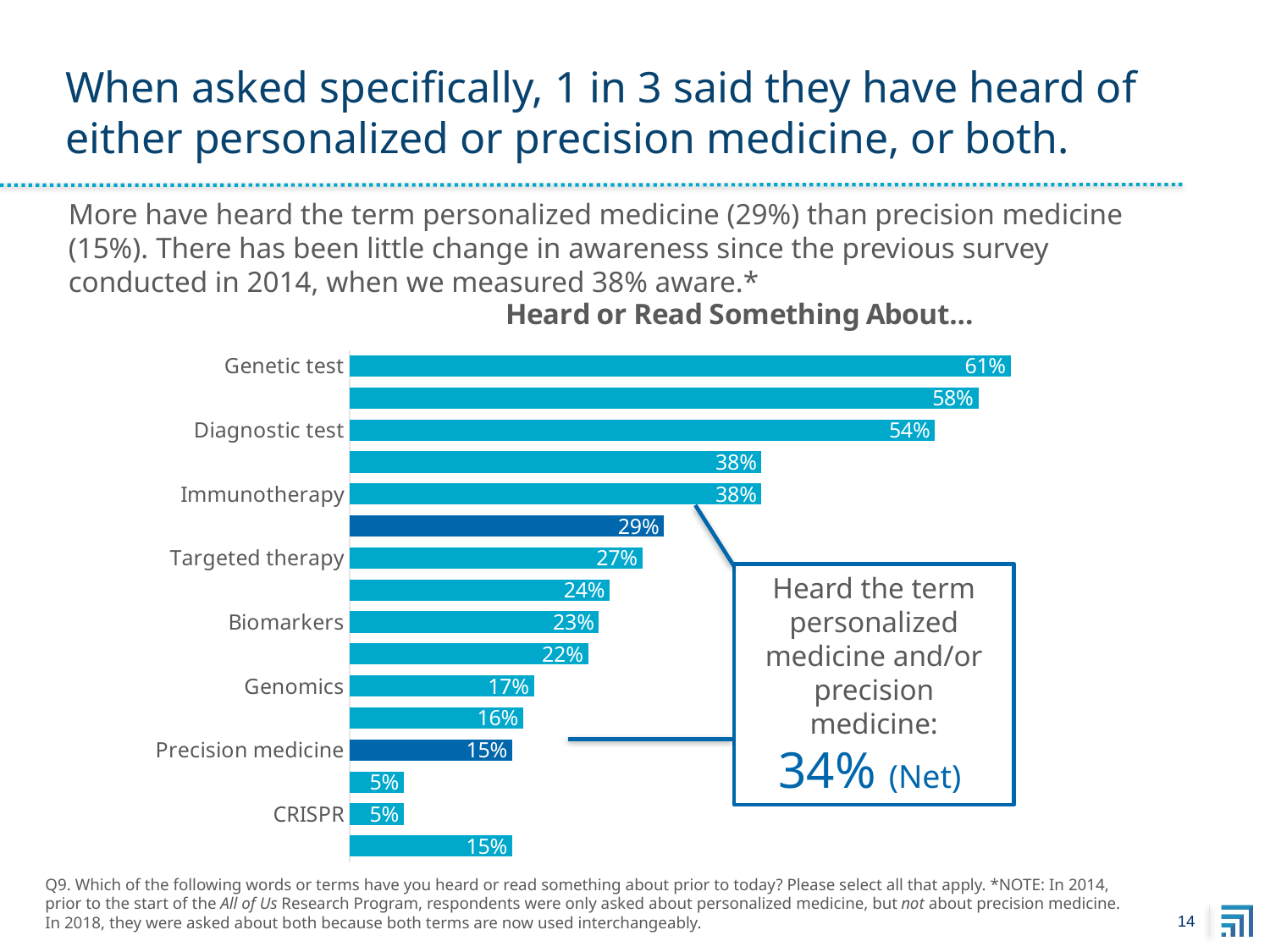
Which is larger, the value for Targeted therapy or the value for Biomarkers? Targeted therapy What is the title of the chart? Heard or Read Something About… How many bars are plotted in the chart? 16 Which category has the highest value? Genetic test What is the difference between the values for Genetic test and Diagnostic test? 7% What is the value for Diagnostic test? 54% What is the value for CRISPR? 5% What is the value for Precision medicine? 15% What is the value for Immunotherapy? 38% What is the value for Genetic test? 61% What kind of chart is shown? Bar chart What is the difference between the values for Immunotherapy and Genomics? 21%